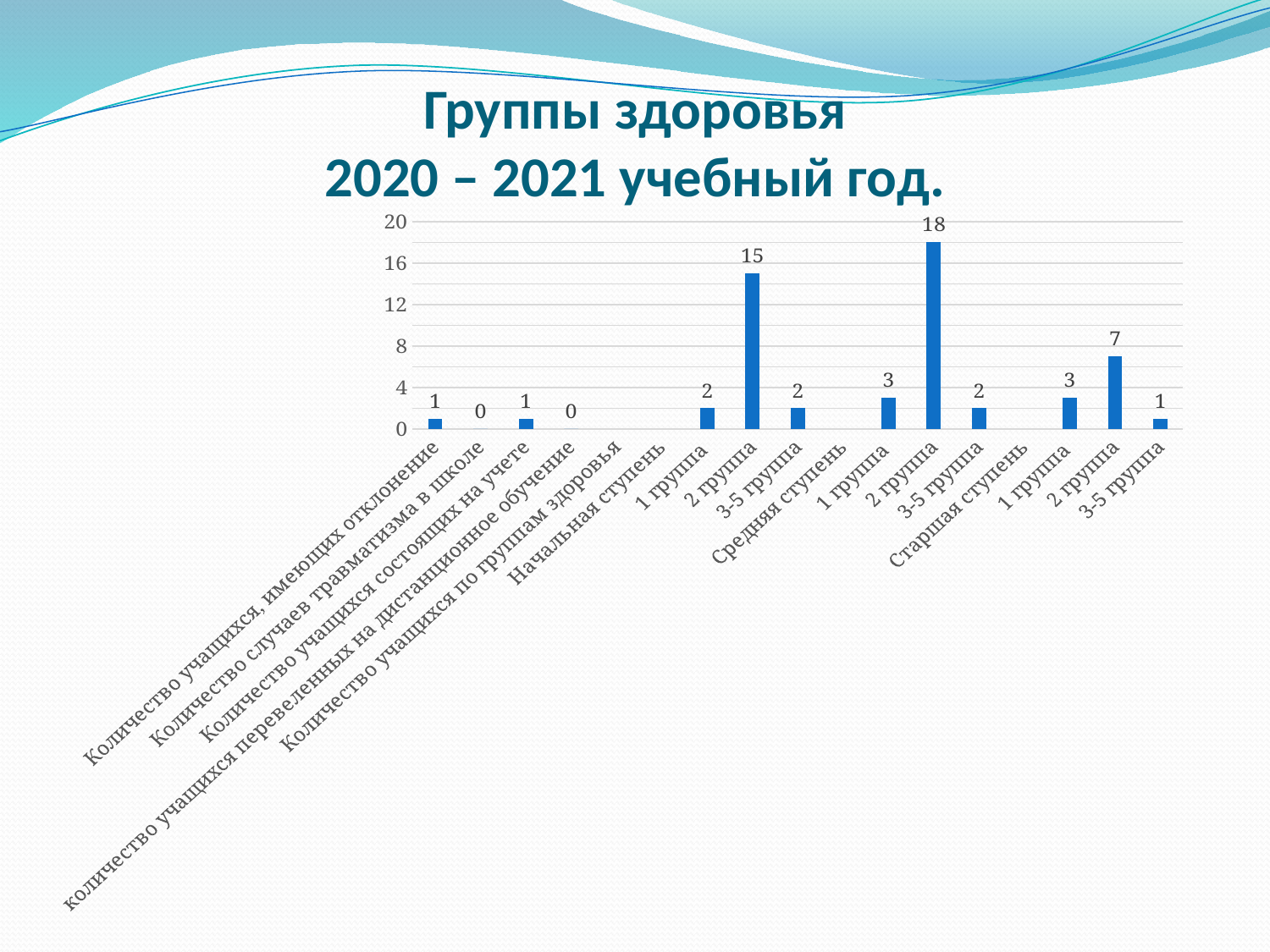
Which is larger: "1 группа" in "Средняя ступень" or "1 группа" in "Начальная ступень"? 1 группа in Средняя ступень What is the difference between the "2 группа" value in "Средняя ступень" and the "2 группа" value in "Старшая ступень"? 11 What is the value for "2 группа" in the "Средняя ступень" section? 18 What kind of chart is shown on the slide? bar chart What is the value for "Количество случаев травматизма в школе"? 0 What is the value for "2 группа" in the "Начальная ступень" section? 15 What is the difference between the "2 группа" value in "Средняя ступень" and the "2 группа" value in "Начальная ступень"? 3 Is the value for "2 группа" in "Старшая ступень" greater or less than 8? less What is the title of the chart on the slide? Группы здоровья 2020 – 2021 учебный год. What is the value for "2 группа" in the "Старшая ступень" section? 7 Which category has the highest value on the chart? 2 группа (Средняя ступень) What is the value for "Количество учащихся, имеющих отклонение"? 1